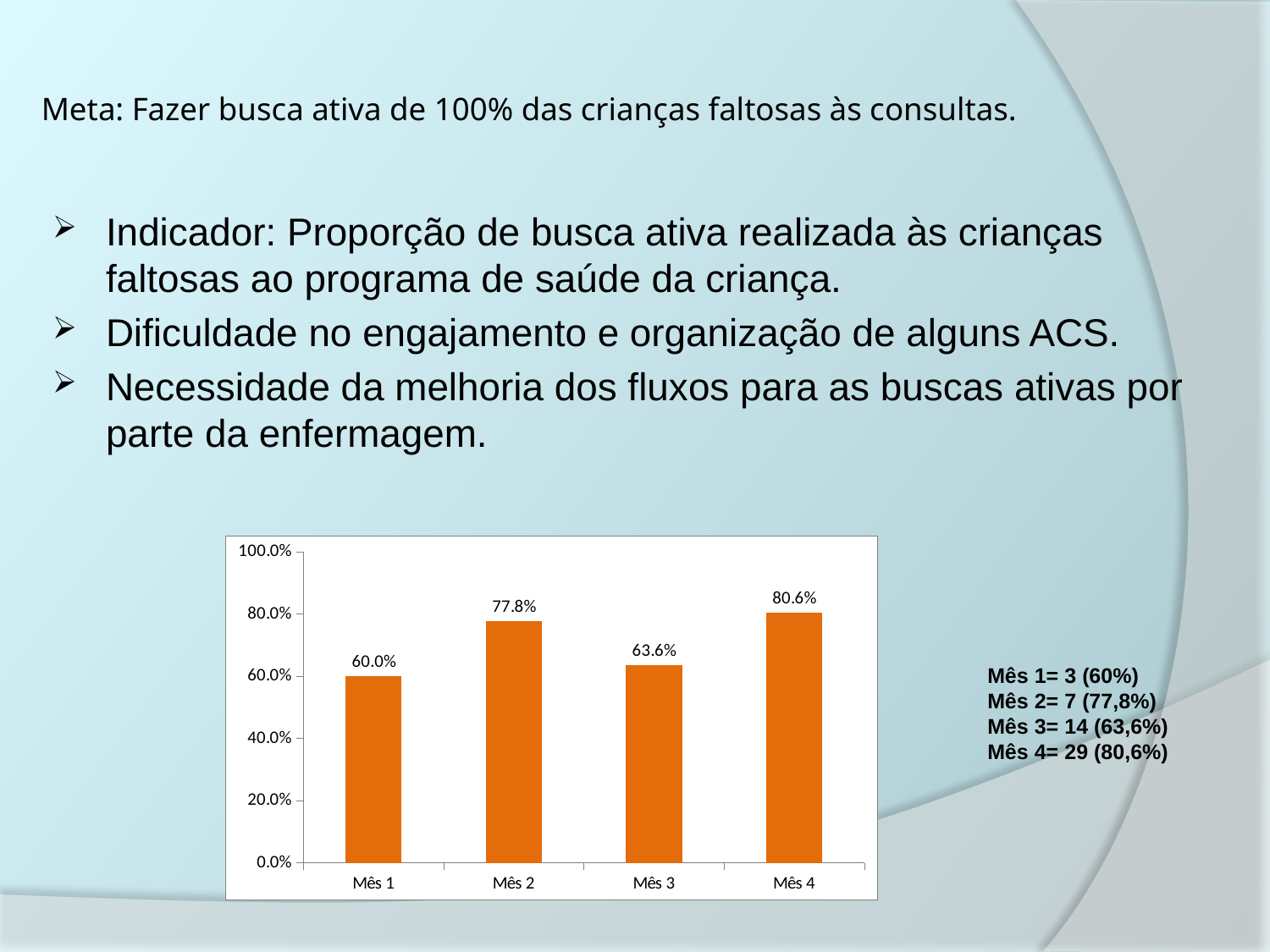
Which is larger, the value for Mês 2 or the value for Mês 3? Mês 2 What is the value for Mês 2? 77.8% Is the value for Mês 3 greater or less than 80.0%? less What kind of chart is shown on the slide? bar chart What is the value for Mês 1? 60.0% How many months are shown on the x axis? 4 What is the value for Mês 3? 63.6% What is the difference between the values for Mês 2 and Mês 3? 14.2% What is the value for Mês 4? 80.6% Which month has the lowest value? Mês 1 Which month has the highest value? Mês 4 What is the difference between the values for Mês 4 and Mês 1? 20.6%